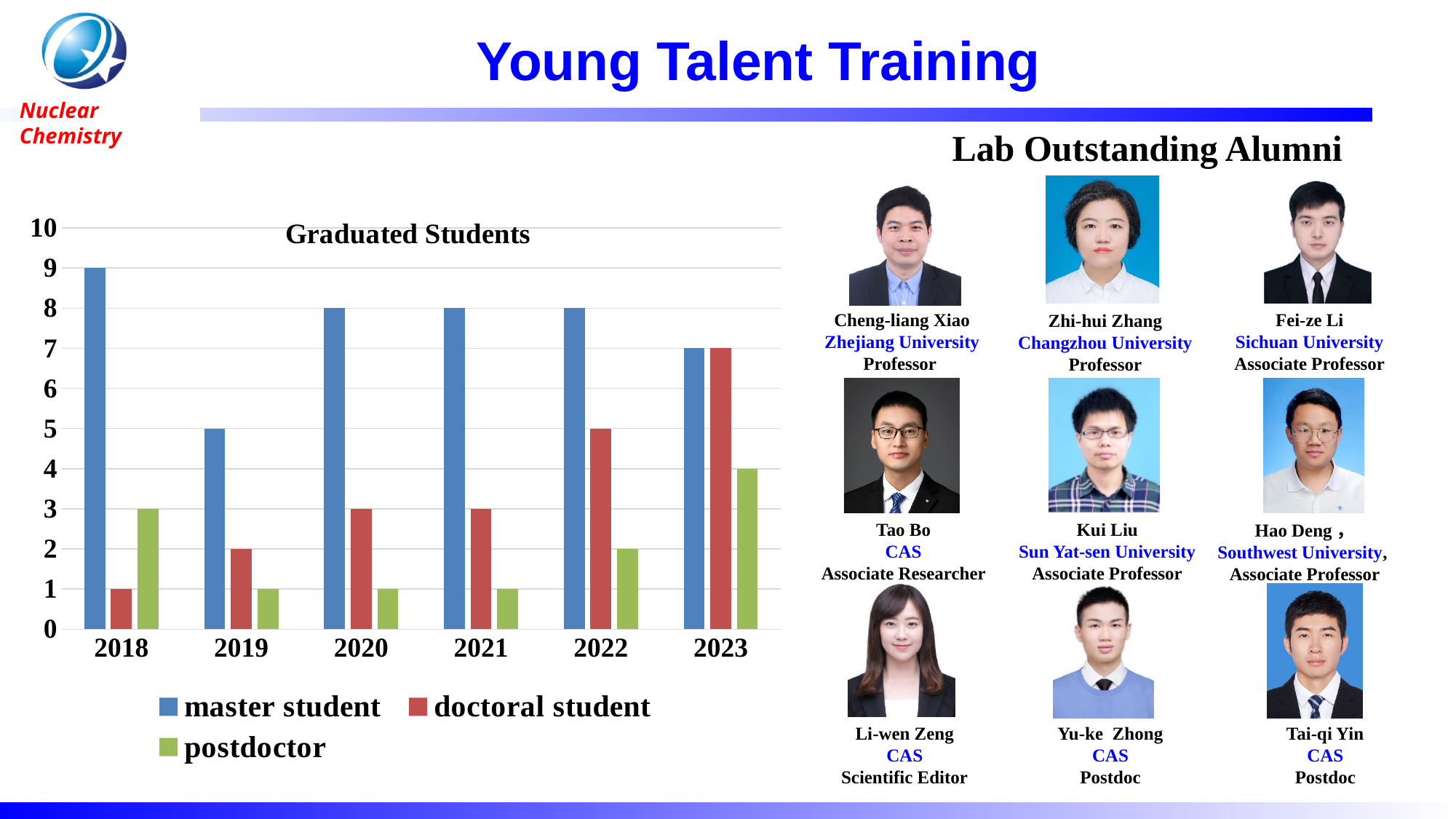
In the Graduated Students chart, which year has the lowest value for doctoral student? 2018 In the Graduated Students chart, what is the value for postdoctor in 2023? 4 In the Graduated Students chart, what is the value for master student in 2018? 9 In the Graduated Students chart, does the doctoral student value rise or fall from 2018 to 2023? rise How many years are shown on the x axis of the Graduated Students chart? 6 How many series does the legend of the Graduated Students chart list? 3 In the Graduated Students chart, which is larger in 2022: master student or doctoral student? master student In the Graduated Students chart, what is the difference between the master student values for 2018 and 2019? 4 What type of chart is the Graduated Students chart? bar chart In the Graduated Students chart, what is the value for doctoral student in 2022? 5 In the Graduated Students chart, which year has the highest value for master student? 2018 What colour represents postdoctor in the Graduated Students chart? green